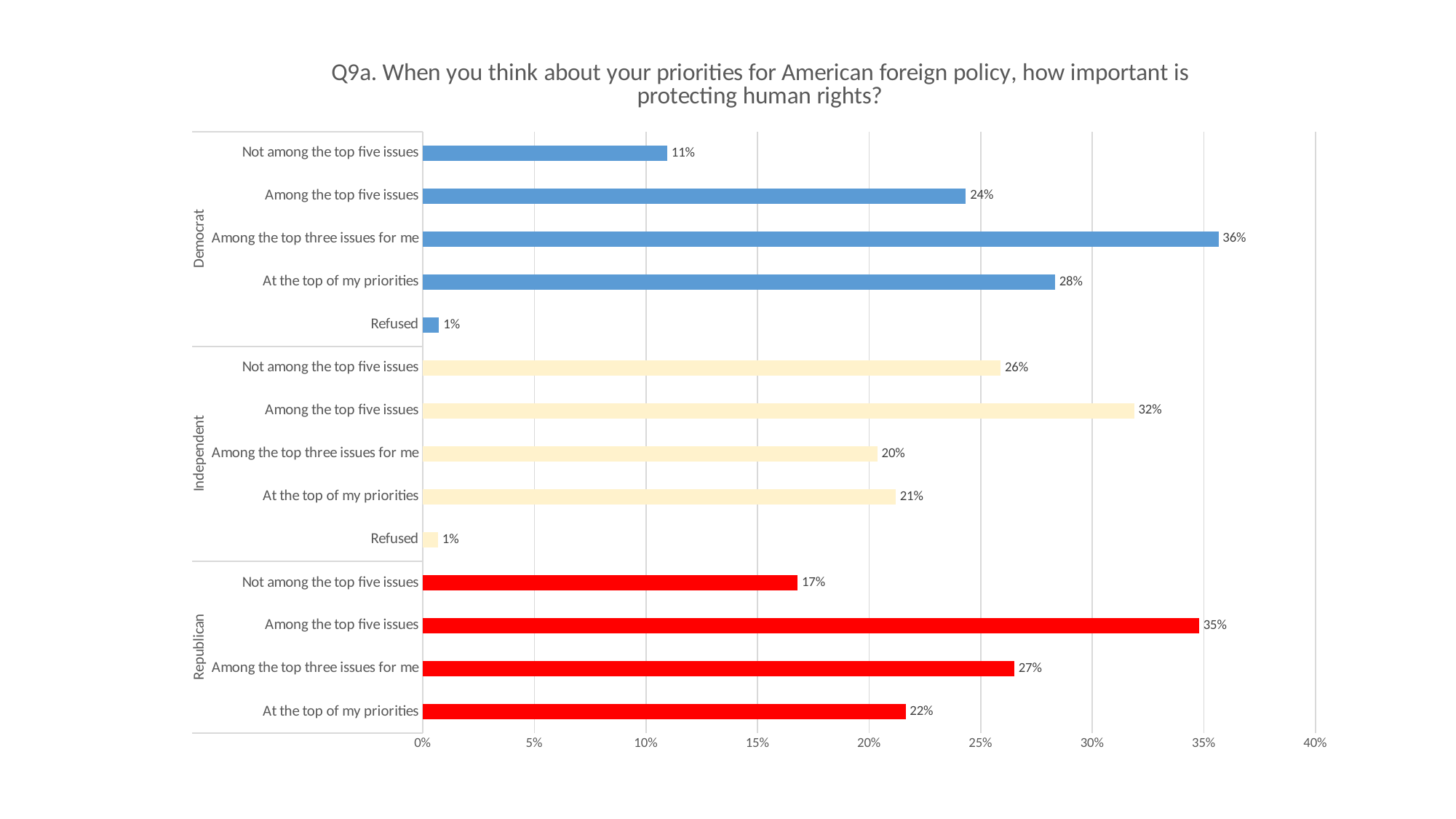
What colour are the bars for the Independent group? Light yellow Which group has a larger percentage for 'Not among the top five issues', Democrats or Independents? Independents What percentage of Independents said protecting human rights is among the top five issues? 32% What is the difference between the Democrat and Republican percentages for 'At the top of my priorities'? 6% Which response has the lowest percentage among Democrats? Refused How many bars are plotted for the Republican group? 4 What is the maximum value shown on the horizontal axis? 40% Is the Republican value for 'Among the top three issues for me' greater or less than 25%? greater What type of chart is shown on the slide? Bar chart What percentage of Republicans said protecting human rights is not among the top five issues? 17% Which response has the highest percentage among Republicans? Among the top five issues What percentage of Democrats said protecting human rights is among the top three issues for them? 36%